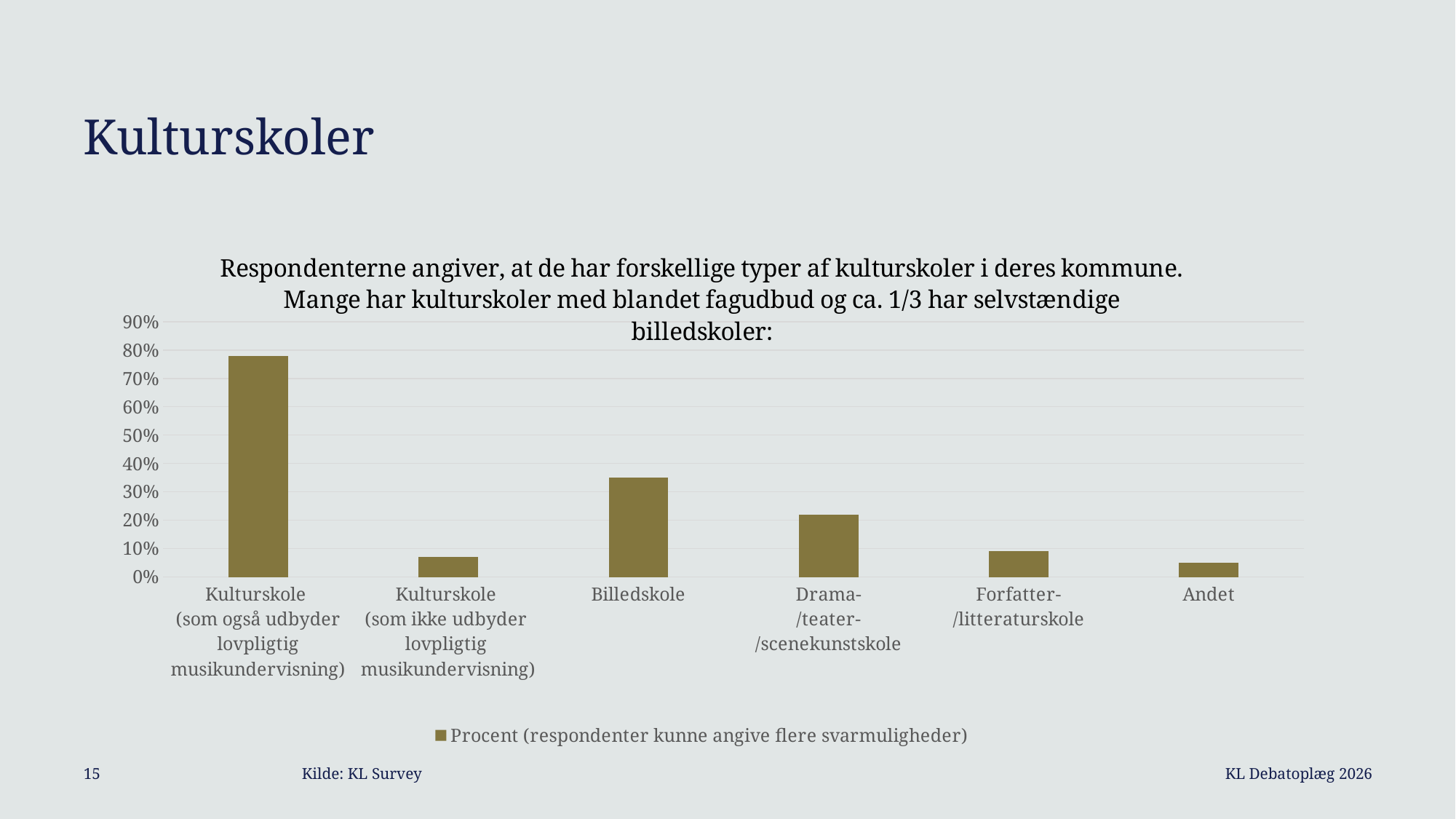
Is the value for Kulturskole (som også udbyder lovpligtig musikundervisning) greater or less than 70%? greater Which has the larger value, Forfatter-/litteraturskole or Andet? Forfatter-/litteraturskole Is the value for Andet greater or less than 10%? less How many series does the chart legend list? 1 Is the value for Drama-/teater-/scenekunstskole greater or less than 30%? less What kind of chart is shown on the slide? Bar chart Which category has the lowest value in the chart? Andet How many categories are shown on the x axis of the chart? 6 What is the legend entry of the series shown in the chart? Procent (respondenter kunne angive flere svarmuligheder) Which category has the highest value in the chart? Kulturskole (som også udbyder lovpligtig musikundervisning) Which has the larger value, Billedskole or Drama-/teater-/scenekunstskole? Billedskole